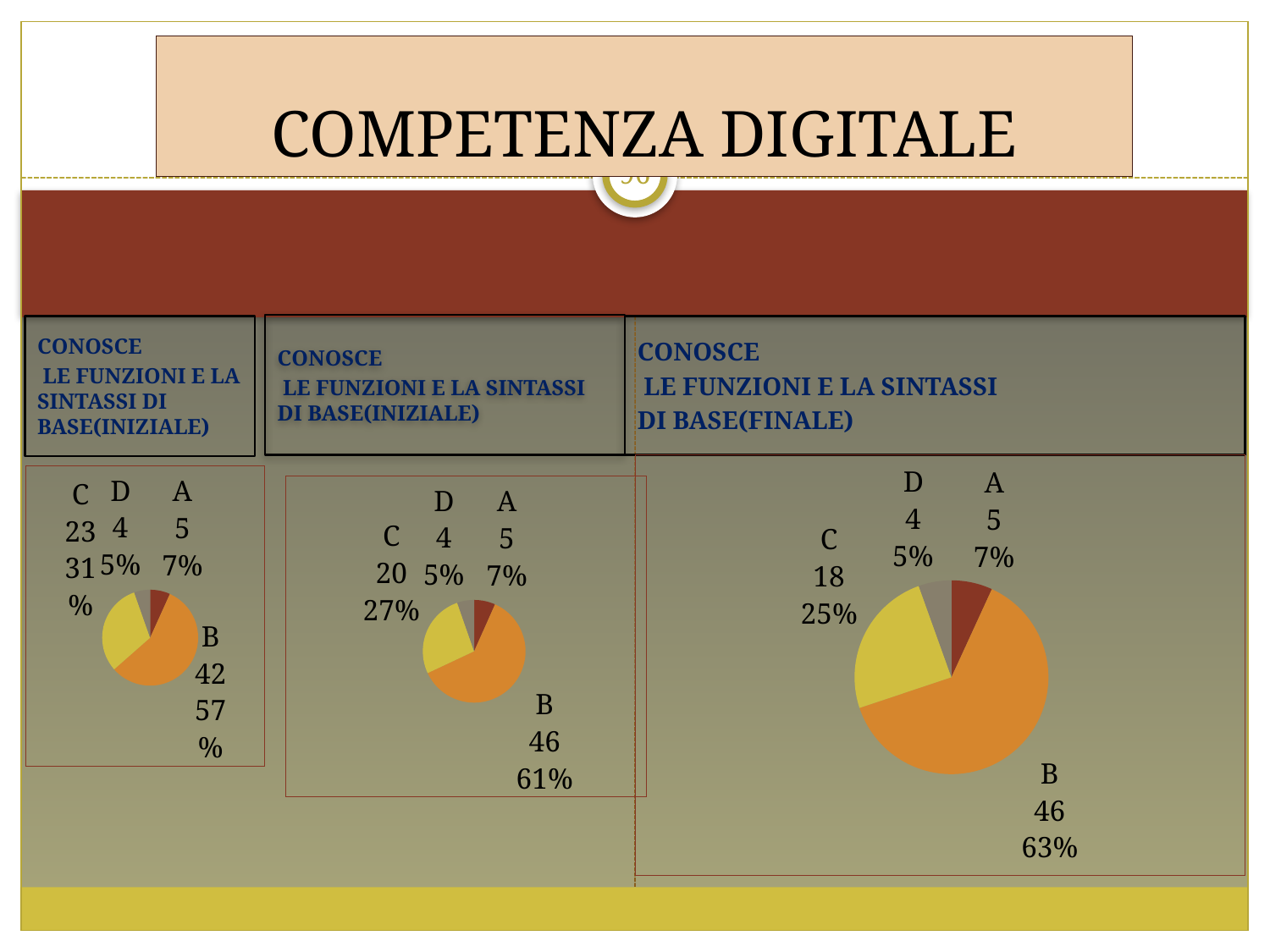
In the rightmost pie chart (FINALE), which category has the largest slice? B In the rightmost pie chart (FINALE), which category has the smallest slice? D How many pie charts are shown on the slide? 3 In the middle pie chart, what is the difference between the values for B and C? 26 How many categories does the rightmost pie chart (FINALE) show? 4 In the middle pie chart, what is the value for C? 20 In the leftmost pie chart, which is larger, the value for A or the value for D? A In the leftmost pie chart, what share of the pie does B have? 57% What kind of chart is the rightmost chart on the slide? pie chart In the rightmost pie chart (FINALE), what is the value for B? 46 In the rightmost pie chart (FINALE), what share of the pie does C have? 25% In the leftmost pie chart, what is the value for C? 23